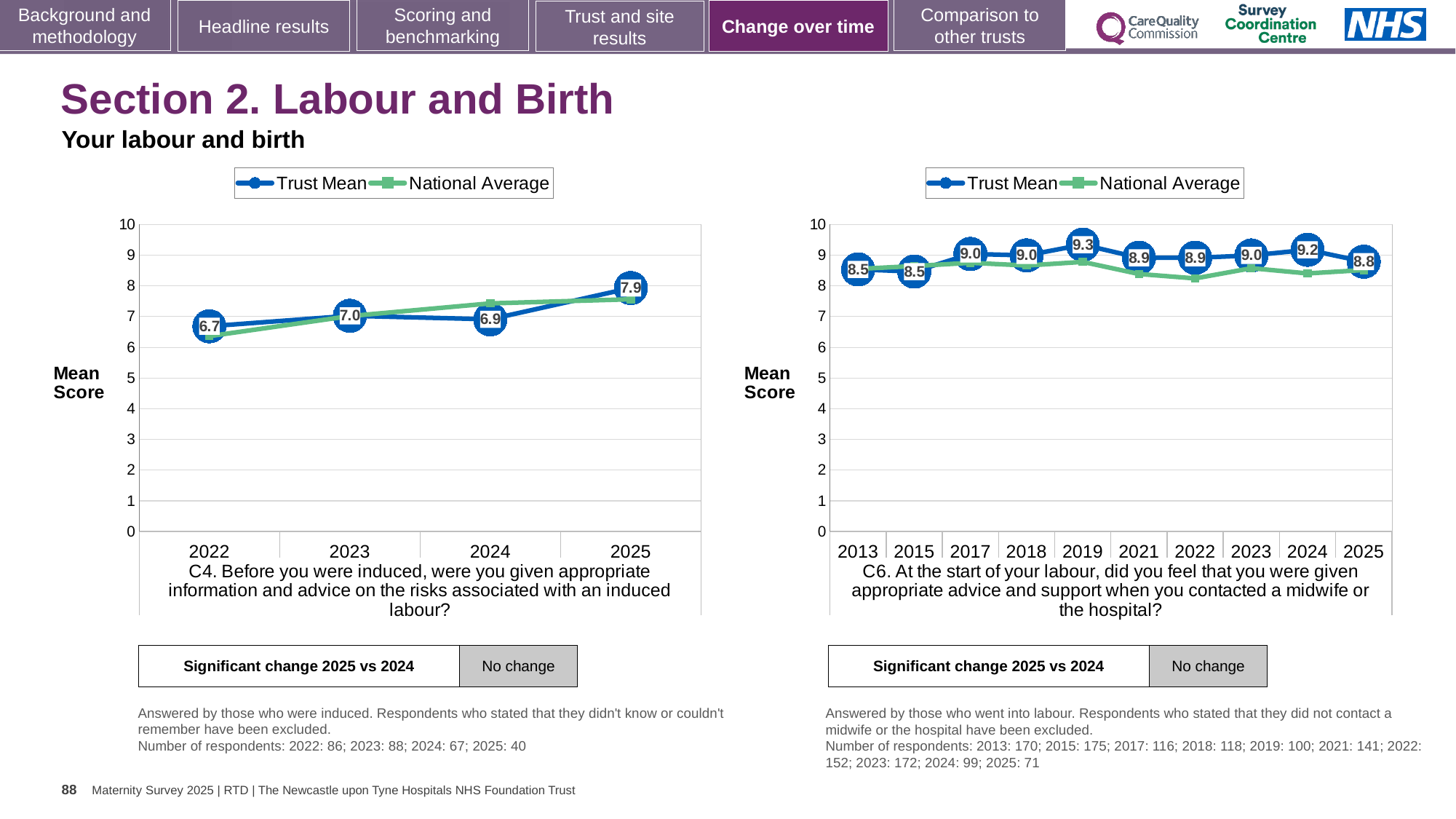
In the C4 chart (left), which year has the lowest Trust Mean score? 2022 In the C6 chart (right), what is the Trust Mean score for 2025? 8.8 In the C6 chart (right), what is the Trust Mean score for 2019? 9.3 In the C4 chart (left), how many years are shown on the x axis? 4 In the C6 chart (right), is the Trust Mean score for 2024 greater or less than the Trust Mean score for 2025? greater In the C4 chart (left), which year has the highest Trust Mean score? 2025 In the C4 chart (left), what is the difference between the Trust Mean scores for 2025 and 2024? 1.0 In the C4 chart (left), what is the Trust Mean score for 2022? 6.7 In the C4 chart (left), what is the Trust Mean score for 2025? 7.9 How many series does the legend of the C6 chart (right) list? 2 In the C6 chart (right), how many years are shown on the x axis? 10 In the C6 chart (right), which year has the highest Trust Mean score? 2019